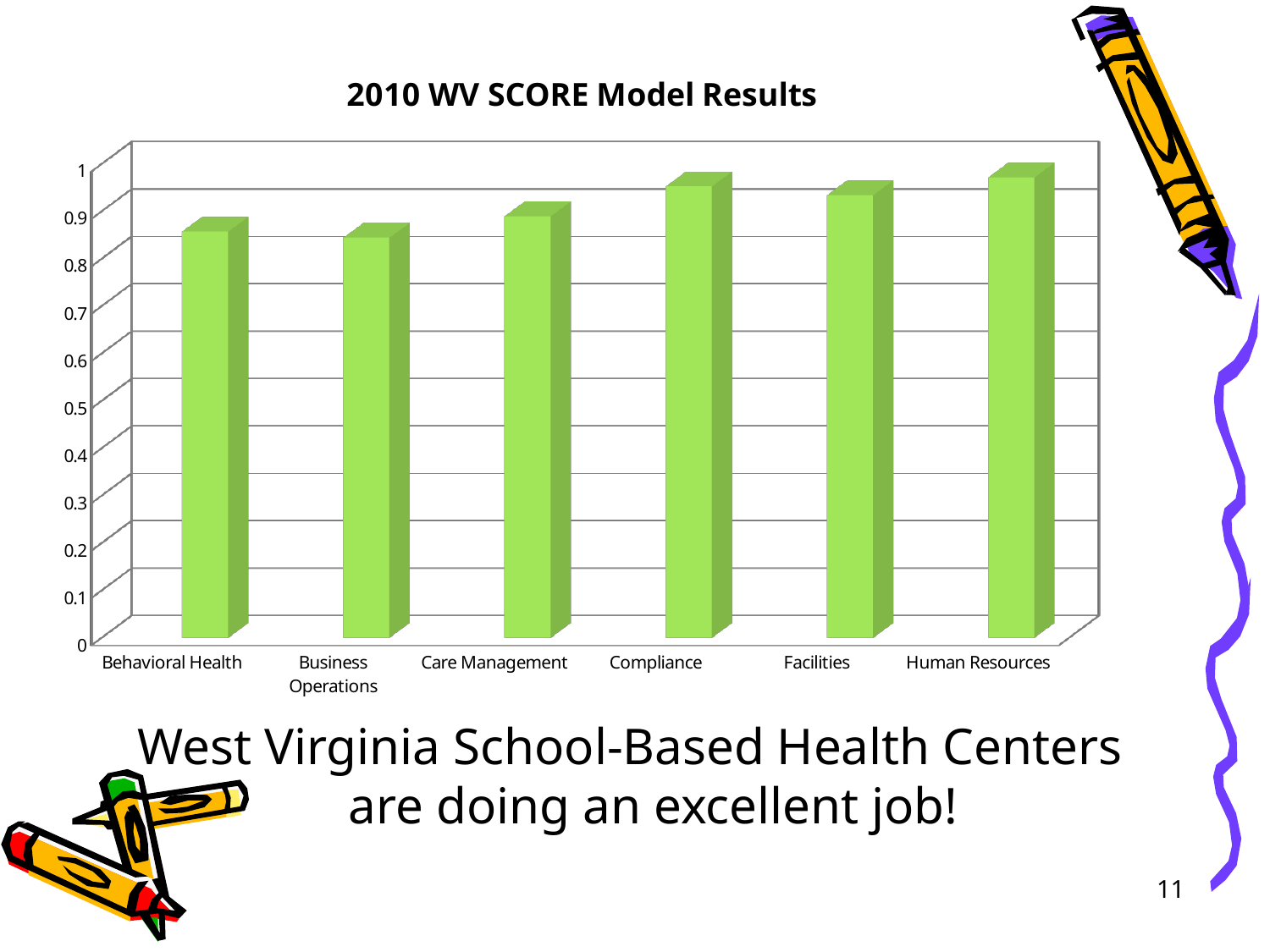
Which category has the highest value in the chart? Human Resources Is the value for Human Resources greater or less than 0.9? greater Which is larger, the value for Human Resources or the value for Business Operations? Human Resources How many categories are shown on the x axis of the chart? 6 Is the value for Compliance greater or less than 0.9? greater Which is larger, the value for Compliance or the value for Behavioral Health? Compliance What is the title of the chart? 2010 WV SCORE Model Results What kind of chart is shown on the slide? bar chart Is the value for Behavioral Health greater or less than 0.9? less What colour are the bars in the chart? green